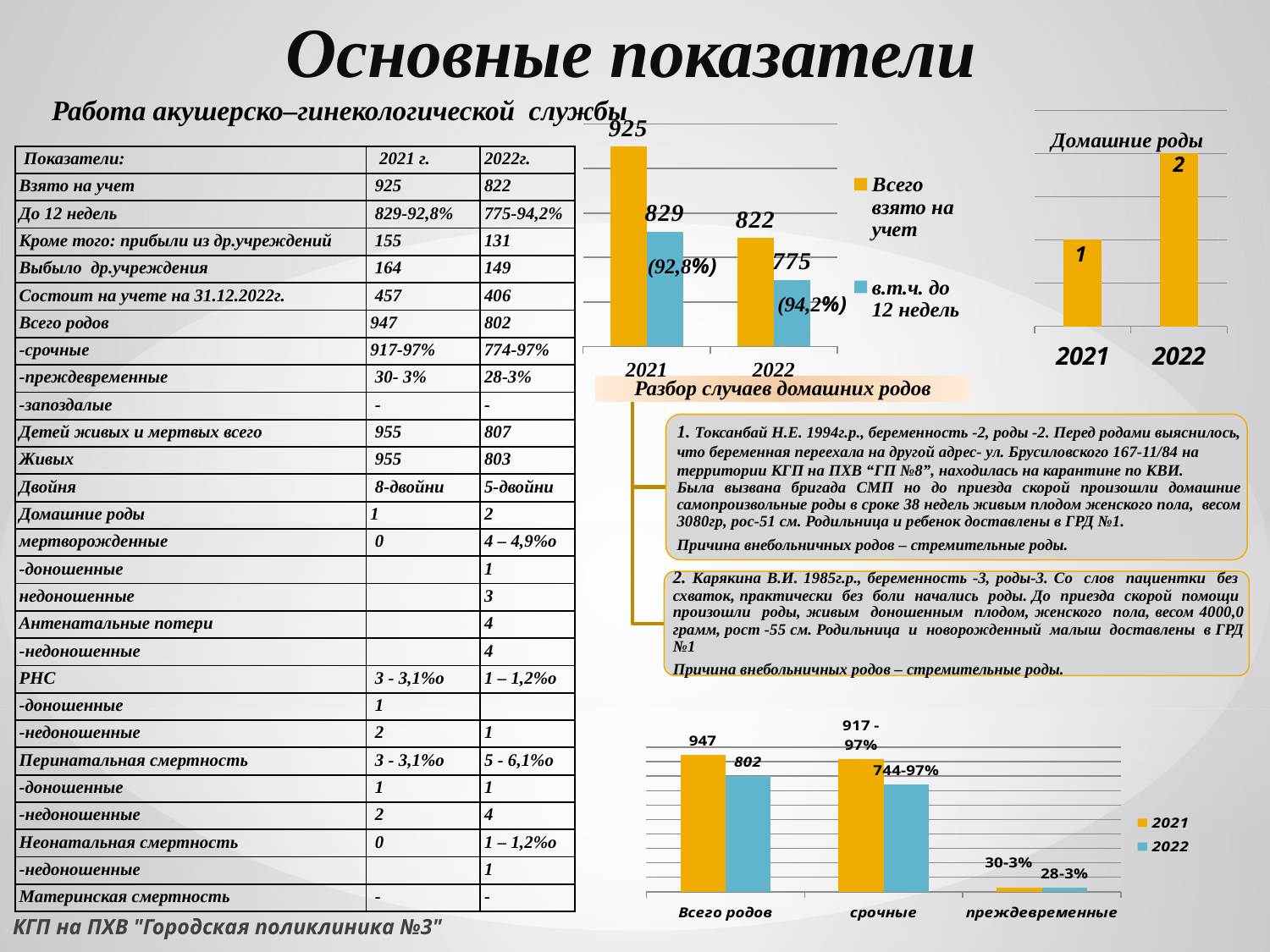
In the top-middle chart, what is the value of 'в.т.ч. до 12 недель' for 2022? 775 In the top-middle chart, what is the difference between 'Всего взято на учет' in 2021 and in 2022? 103 In the 'Домашние роды' chart, what is the value for 2022? 2 In the top-middle chart, does 'Всего взято на учет' rise or fall from 2021 to 2022? fall How many categories are shown on the x axis of the bottom chart? 3 How many series does the legend of the top-middle chart list? 2 In the bottom chart, what is the value of 'Всего родов' for 2022? 802 What kind of chart is the 'Домашние роды' chart? bar chart In the bottom chart, which category has the lowest values? преждевременные In the top-middle chart, what is the value of 'Всего взято на учет' for 2021? 925 In the bottom chart, what is the difference between 'Всего родов' in 2021 and in 2022? 145 In the 'Домашние роды' chart, which year has the higher value, 2021 or 2022? 2022